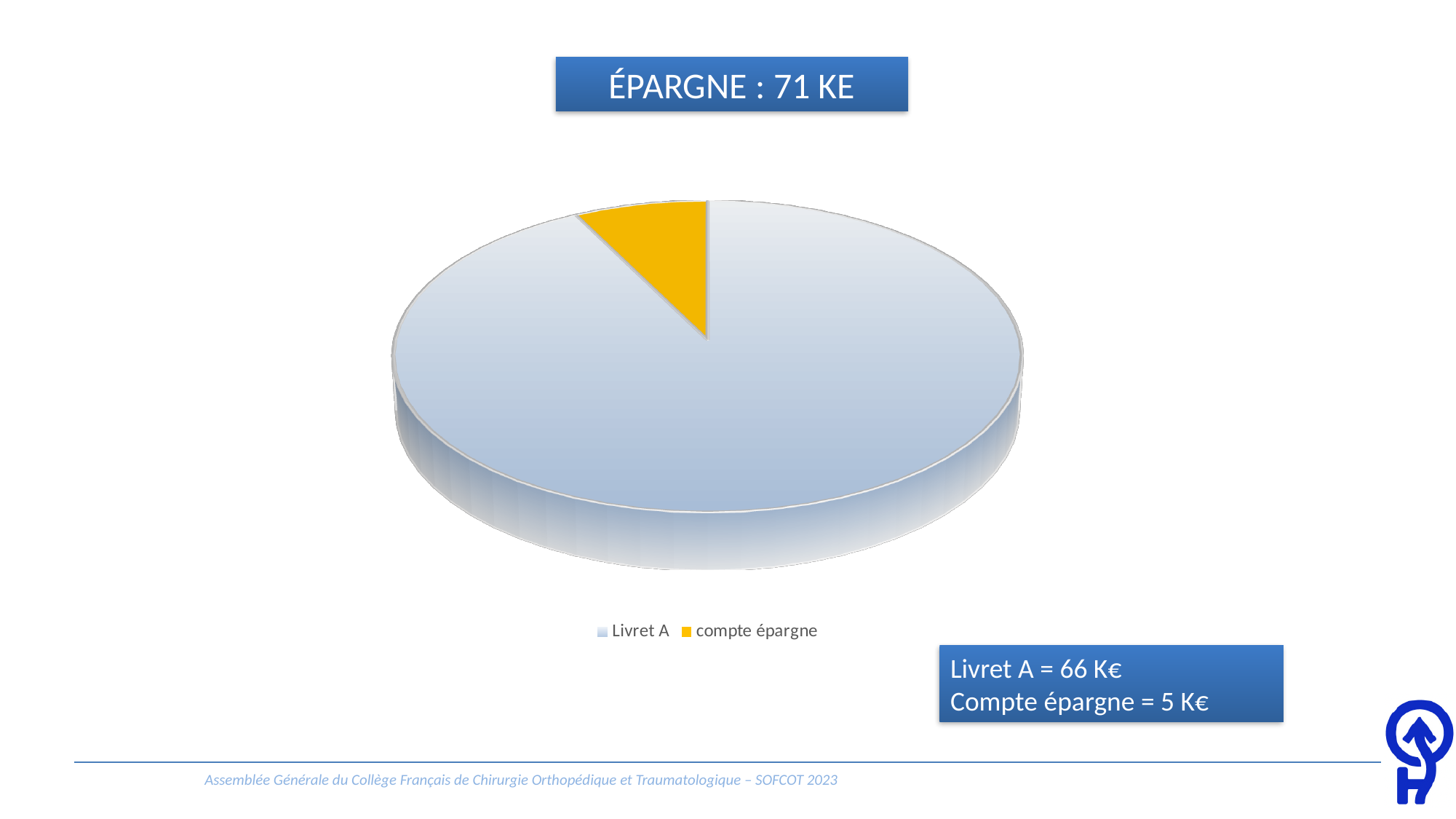
Which slice of the pie chart is the smallest? compte épargne What is the difference between the Livret A value and the Compte épargne value? 61 K€ Which is larger, Livret A or Compte épargne? Livret A Which slice of the pie chart is the largest? Livret A How many entries does the legend of the pie chart list? 2 What kind of chart is shown on the slide? Pie chart What colour is the compte épargne slice in the pie chart? Yellow What is the value for Compte épargne? 5 K€ What is the value for Livret A? 66 K€ How many slices does the pie chart have? 2 What is the total savings amount shown in the slide title? 71 KE What is the title shown above the pie chart? ÉPARGNE : 71 KE